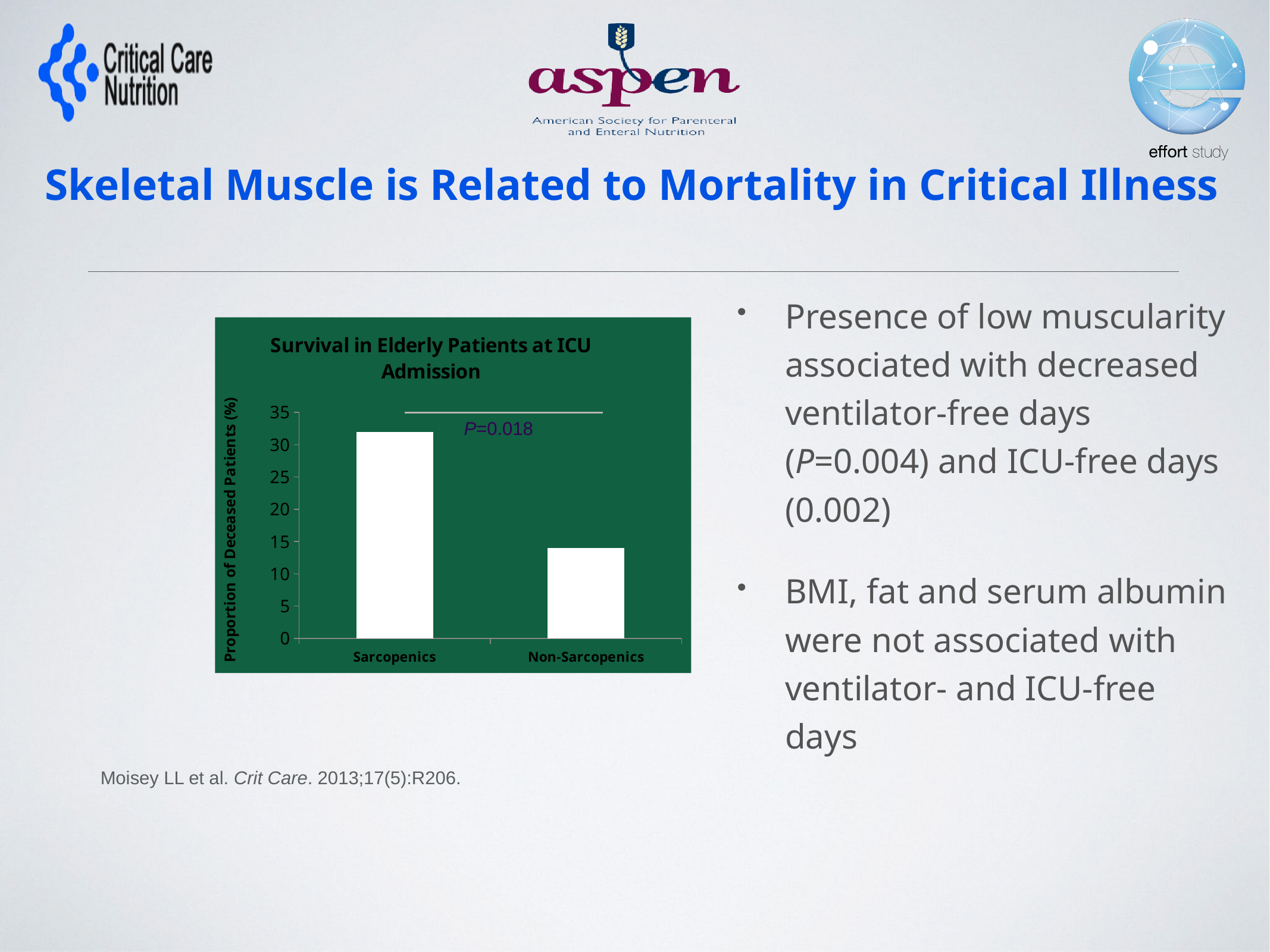
What P value is annotated on the chart between the two bars? P=0.018 Is the value for Non-Sarcopenics greater or less than 10? greater Which category has the highest proportion of deceased patients? Sarcopenics Is the value for Sarcopenics greater or less than 30? greater How many categories are plotted on the x axis of the chart? 2 Which category has the lowest proportion of deceased patients? Non-Sarcopenics Is the value for Sarcopenics greater or less than 35? less What kind of chart is shown on the slide? bar chart Which is larger, the value for Sarcopenics or the value for Non-Sarcopenics? Sarcopenics What is the title of the chart? Survival in Elderly Patients at ICU Admission